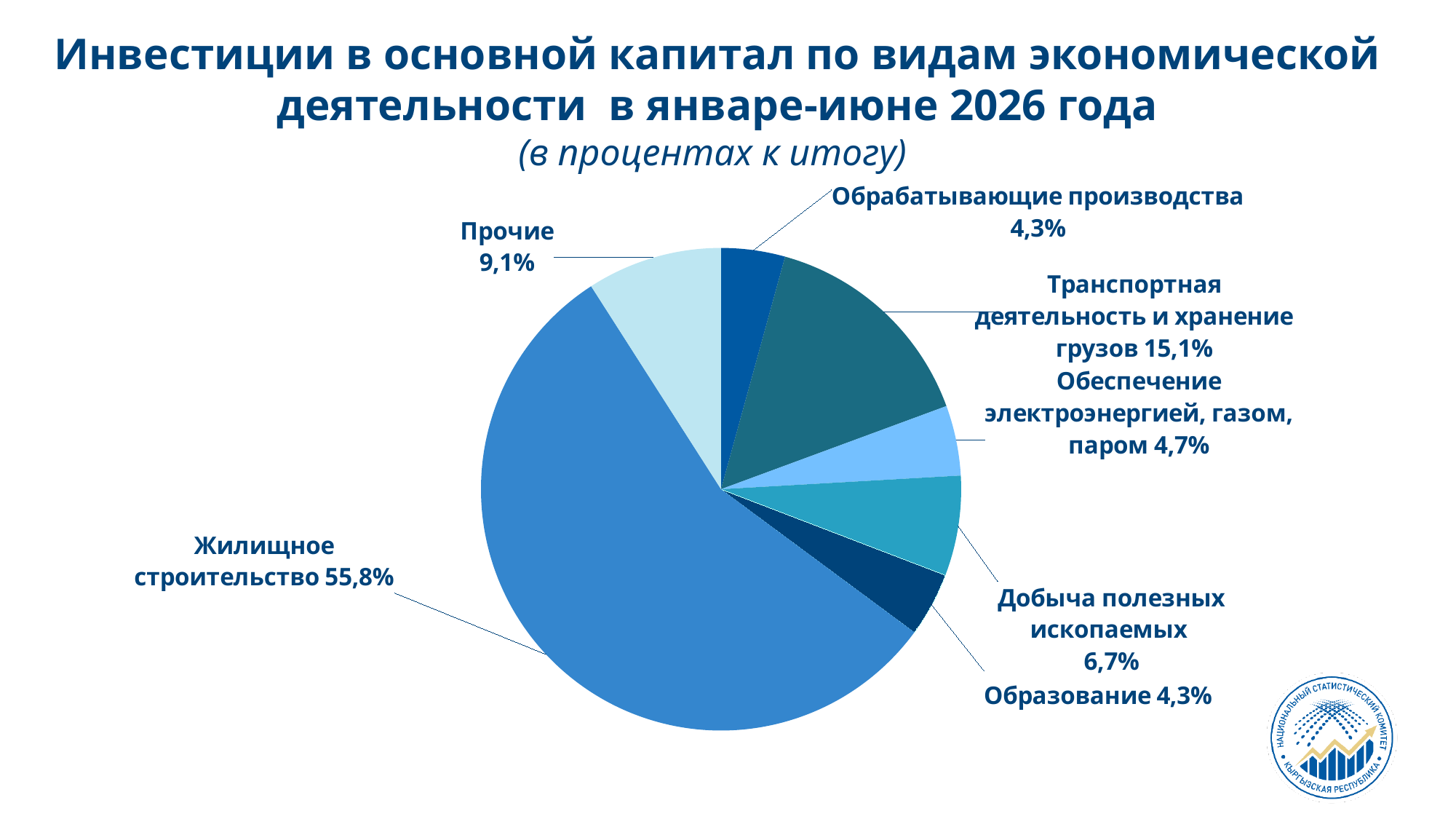
Какова доля категории «Прочие»? 9,1% Какова доля транспортной деятельности и хранения грузов? 15,1% Какова доля обеспечения электроэнергией, газом, паром? 4,7% На сколько процентных пунктов доля транспортной деятельности и хранения грузов больше доли добычи полезных ископаемых? 8,4 Какова доля жилищного строительства в инвестициях в основной капитал? 55,8% Какова доля добычи полезных ископаемых? 6,7% Какой тип диаграммы показан на слайде? Круговая диаграмма Какова суммарная доля обрабатывающих производств и образования? 8,6% Сколько секторов (категорий) показано на круговой диаграмме? 7 Какой вид экономической деятельности имеет наибольшую долю инвестиций? Жилищное строительство Что больше: доля категории «Прочие» или доля образования? Прочие За какой период представлены данные в заголовке диаграммы? Январь-июнь 2026 года